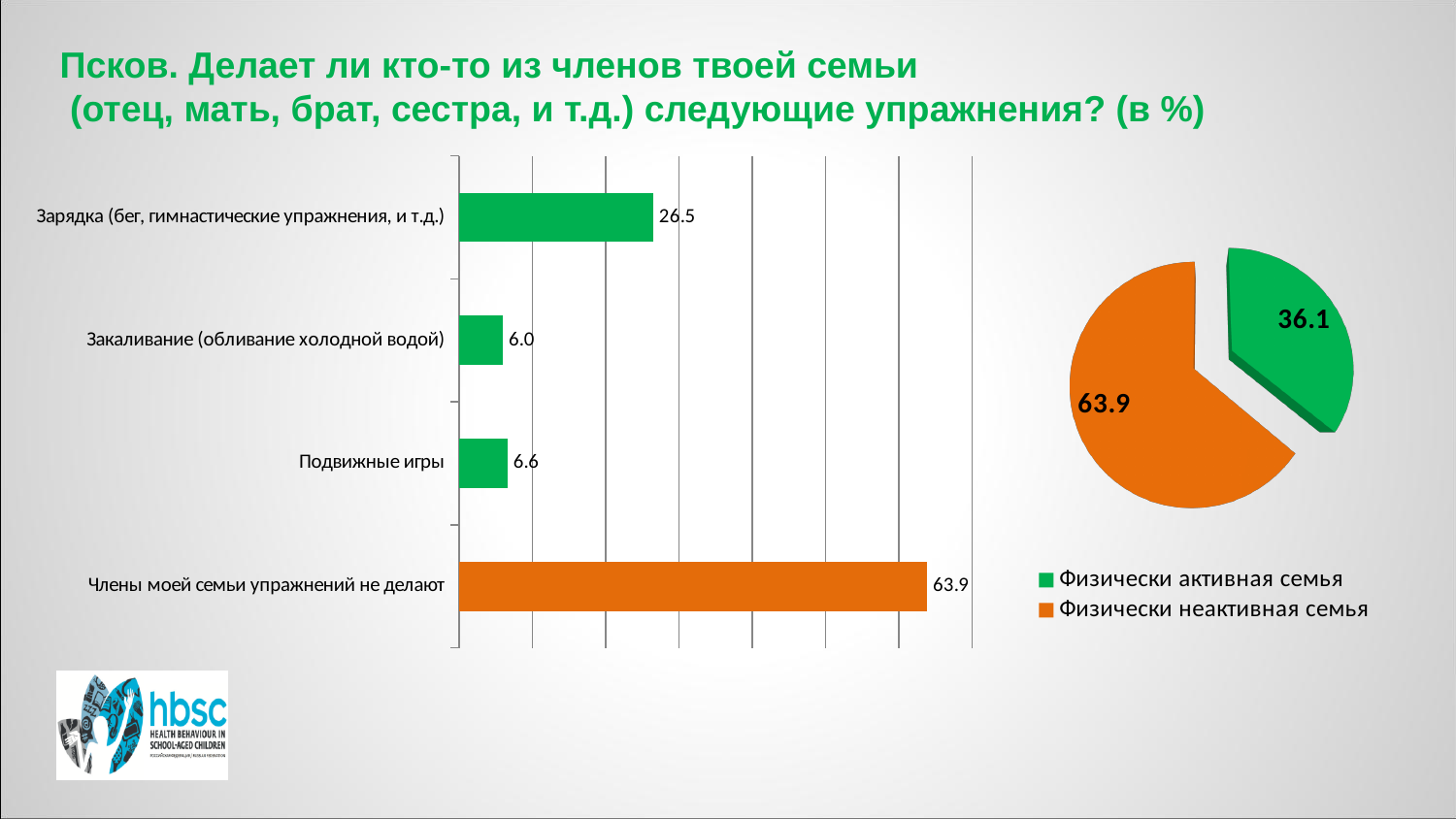
In the pie chart on the right, what is the value for 'Физически активная семья'? 36.1 In the bar chart on the left, what is the value for 'Закаливание (обливание холодной водой)'? 6.0 In the bar chart on the left, what is the difference between the values for 'Члены моей семьи упражнений не делают' and 'Зарядка (бег, гимнастические упражнения, и т.д.)'? 37.4 In the bar chart on the left, which category has the lowest value? Закаливание (обливание холодной водой) How many entries does the legend of the pie chart on the right list? 2 In the bar chart on the left, which is larger: the value for 'Подвижные игры' or for 'Закаливание (обливание холодной водой)'? Подвижные игры How many categories are shown in the bar chart on the left? 4 In the bar chart on the left, what is the value for 'Зарядка (бег, гимнастические упражнения, и т.д.)'? 26.5 In the pie chart on the right, what is the value for 'Физически неактивная семья'? 63.9 In the bar chart on the left, what is the value for 'Подвижные игры'? 6.6 In the bar chart on the left, which category has the highest value? Члены моей семьи упражнений не делают What kind of chart is on the left side of the slide? Bar chart